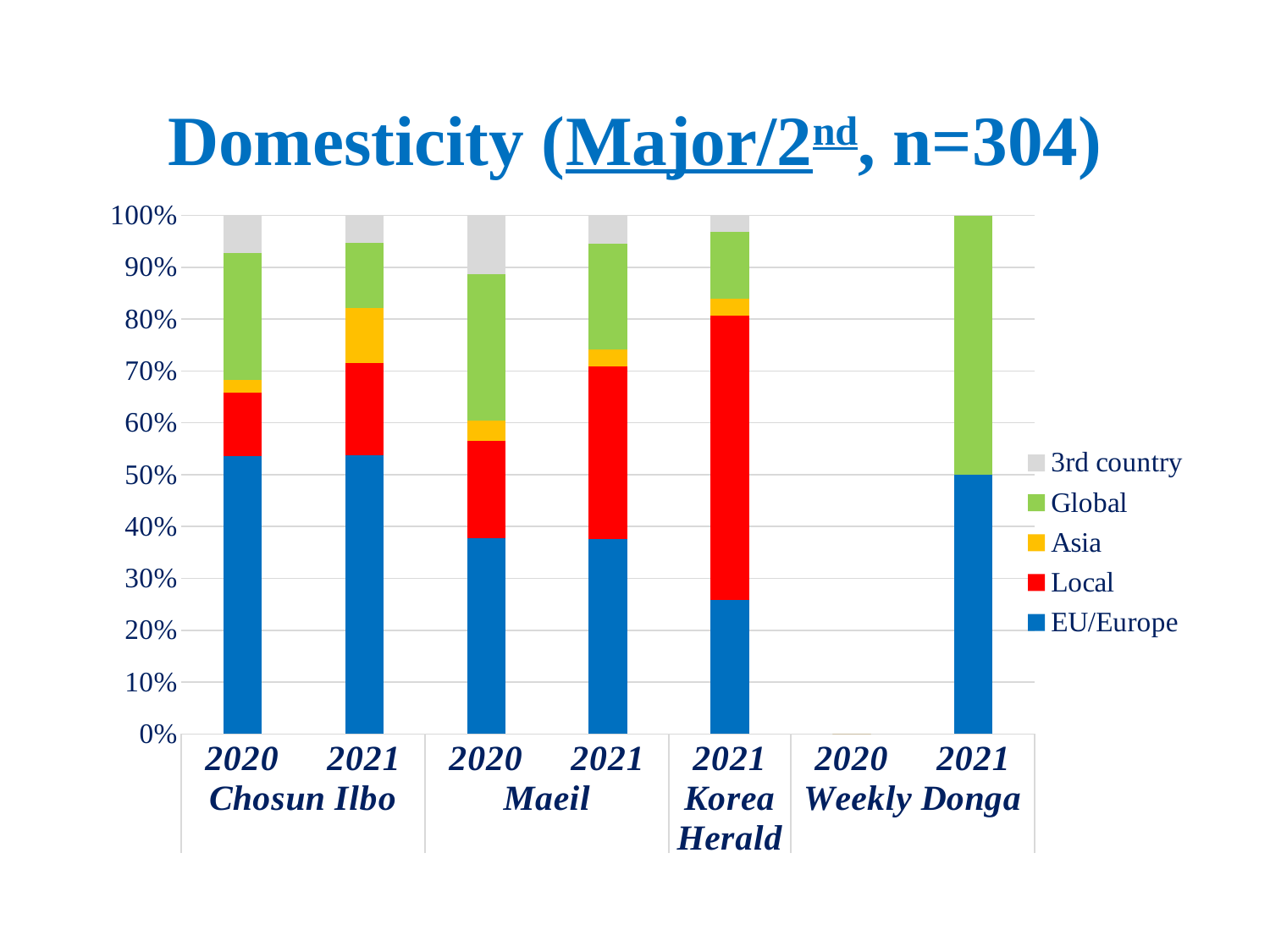
How many newspapers are shown along the x axis? 4 How many series does the legend list? 5 Which bar contains only EU/Europe and Global segments? Weekly Donga 2021 Is the EU/Europe share for Chosun Ilbo 2020 greater or less than 50%? greater What is the sample size stated in the chart title? n=304 What kind of chart is shown on the slide? Stacked bar chart Is the EU/Europe share for Korea Herald 2021 greater or less than 30%? less Is the Local segment for Chosun Ilbo 2021 larger or smaller than the Local segment for Maeil 2021? smaller Which bar has the largest Local segment? Korea Herald 2021 Which newspaper has no bar plotted for 2020? Weekly Donga Which bar has the largest 3rd country segment? Maeil 2020 Is the EU/Europe share for Maeil 2020 greater or less than 40%? less